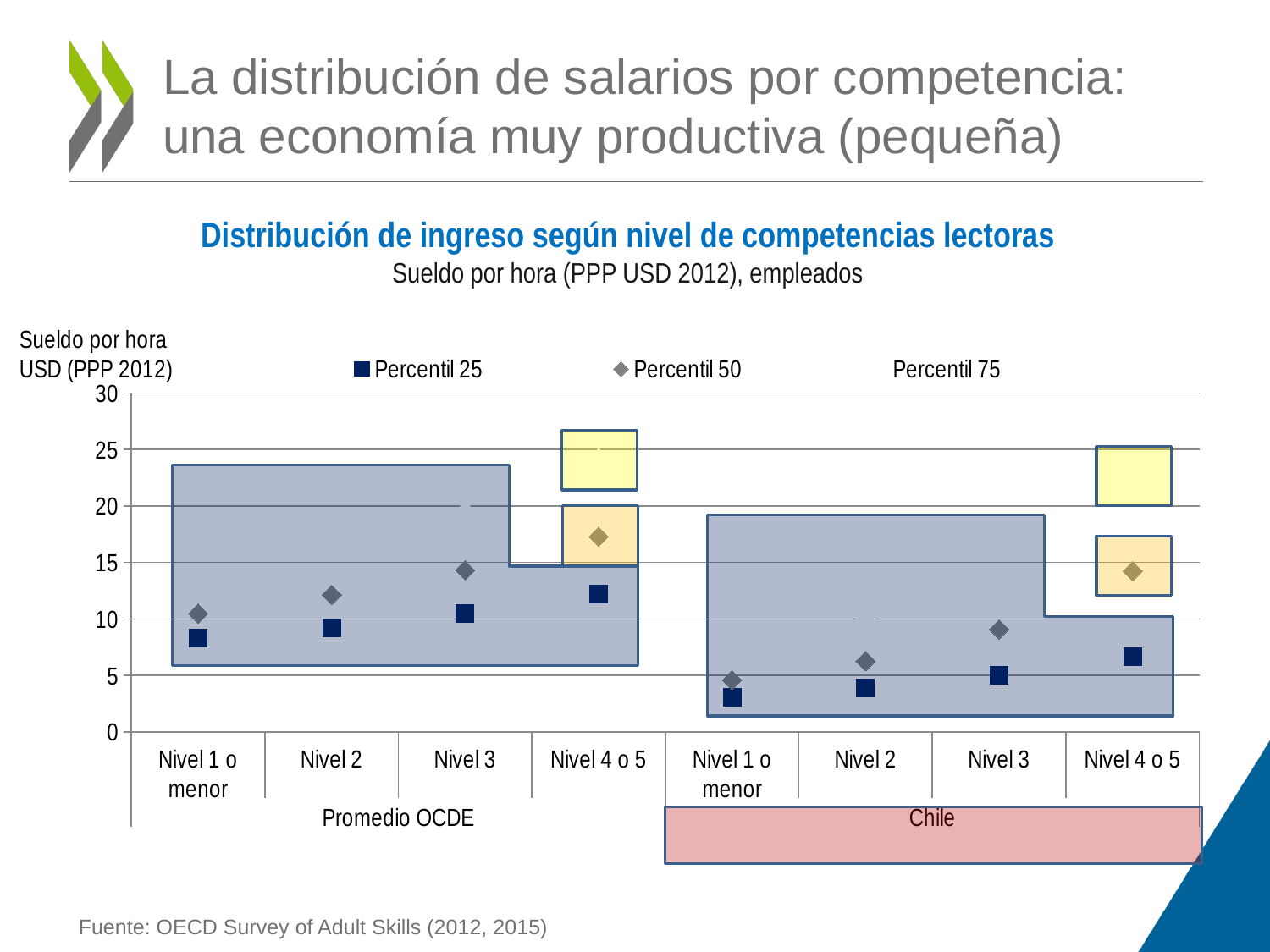
Is the Percentil 25 value for Nivel 4 o 5 in Promedio OCDE greater or less than 10? greater Do the Percentil 50 values for Chile rise or fall from Nivel 1 o menor to Nivel 4 o 5? rise Is the Percentil 25 value for Nivel 1 o menor in Chile greater or less than 5? less Which is larger: the Percentil 25 value for Nivel 1 o menor in Promedio OCDE or for Nivel 4 o 5 in Chile? Nivel 1 o menor in Promedio OCDE Which category has the highest Percentil 50 value? Nivel 4 o 5, Promedio OCDE Is the Percentil 50 value for Nivel 4 o 5 in Promedio OCDE greater or less than 15? greater Which category has the lowest Percentil 25 value? Nivel 1 o menor, Chile How many series does the legend list? 3 How many skill-level categories are plotted along the x axis in total? 8 What is the highest value shown on the y axis? 30 Which is larger: the Percentil 50 value for Nivel 2 in Promedio OCDE or for Nivel 2 in Chile? Nivel 2 in Promedio OCDE